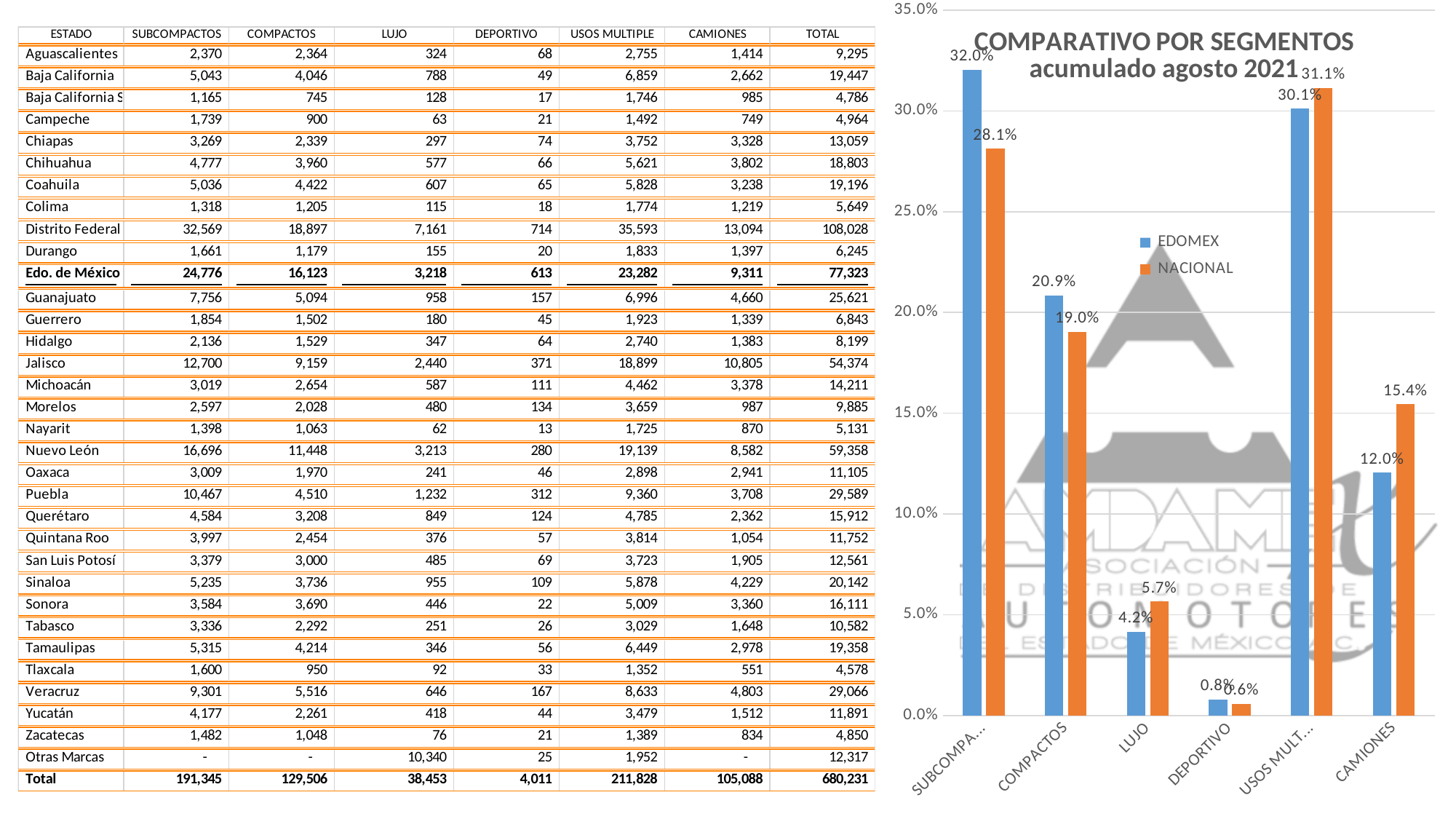
What type of chart is shown on the right side of the slide? bar chart For COMPACTOS, which series has the larger value in the chart, EDOMEX or NACIONAL? EDOMEX What is the NACIONAL value for DEPORTIVO in the chart? 0.6% Which category has the lowest EDOMEX value in the chart? DEPORTIVO What colour are the NACIONAL bars in the chart? orange For LUJO, which series has the larger value in the chart, EDOMEX or NACIONAL? NACIONAL What is the EDOMEX value for COMPACTOS in the chart? 20.9% How many series does the legend of the chart list? 2 What is the EDOMEX value for LUJO in the chart? 4.2% How many categories are shown on the x axis of the chart? 6 What is the NACIONAL value for CAMIONES in the chart? 15.4% What is the difference between the EDOMEX and NACIONAL values for CAMIONES in the chart? 3.4%